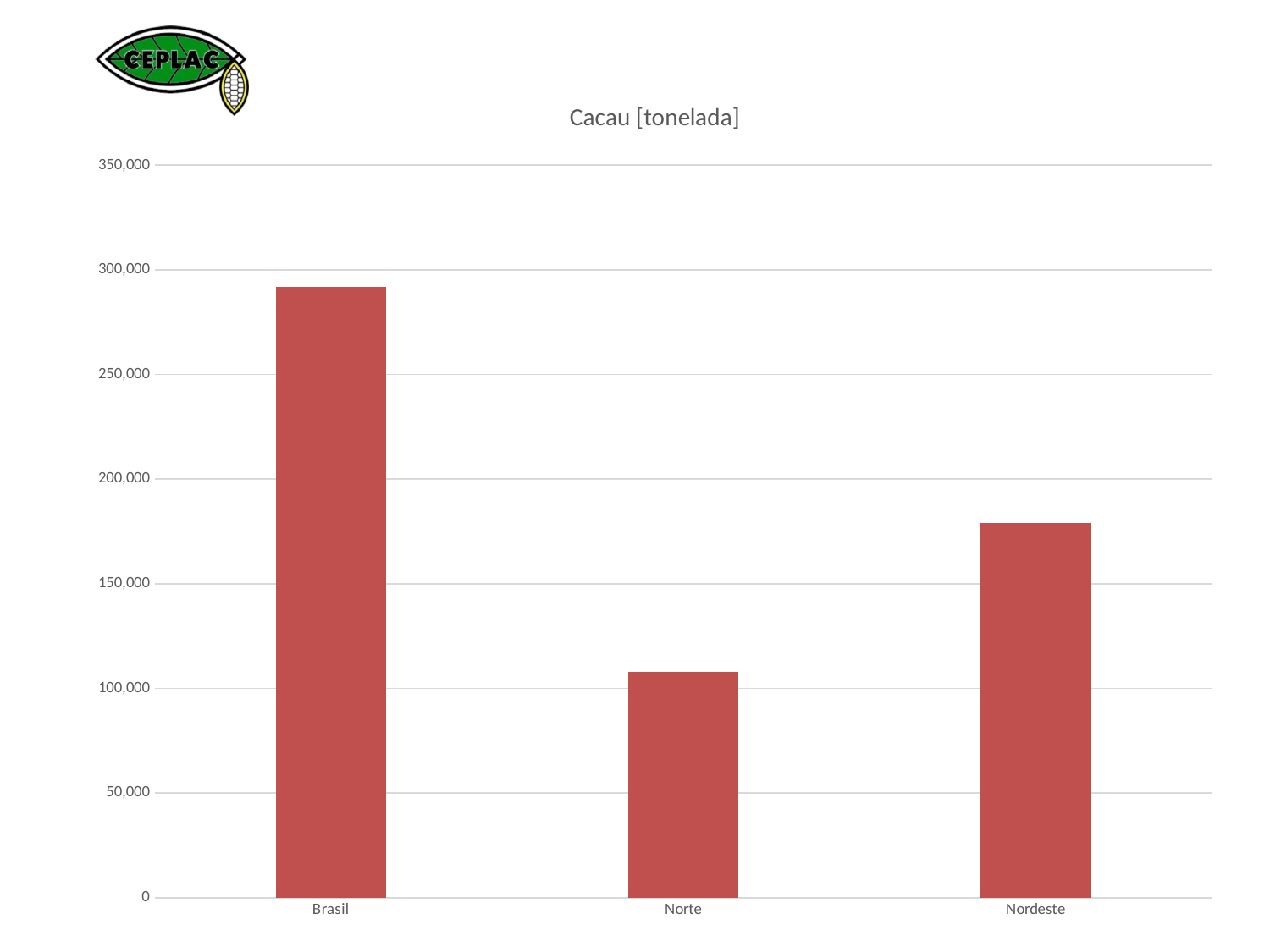
What is the highest value shown on the y axis? 350,000 Which category has the lowest value? Norte Is the value for Norte greater or less than 150,000? less Which is larger, the value for Norte or the value for Nordeste? Nordeste What kind of chart is shown on the slide? bar chart Is the value for Nordeste greater or less than 200,000? less Is the value for Brasil greater or less than 250,000? greater How many categories are shown on the x axis? 3 Which category has the highest value? Brasil What is the title of the chart? Cacau [tonelada]